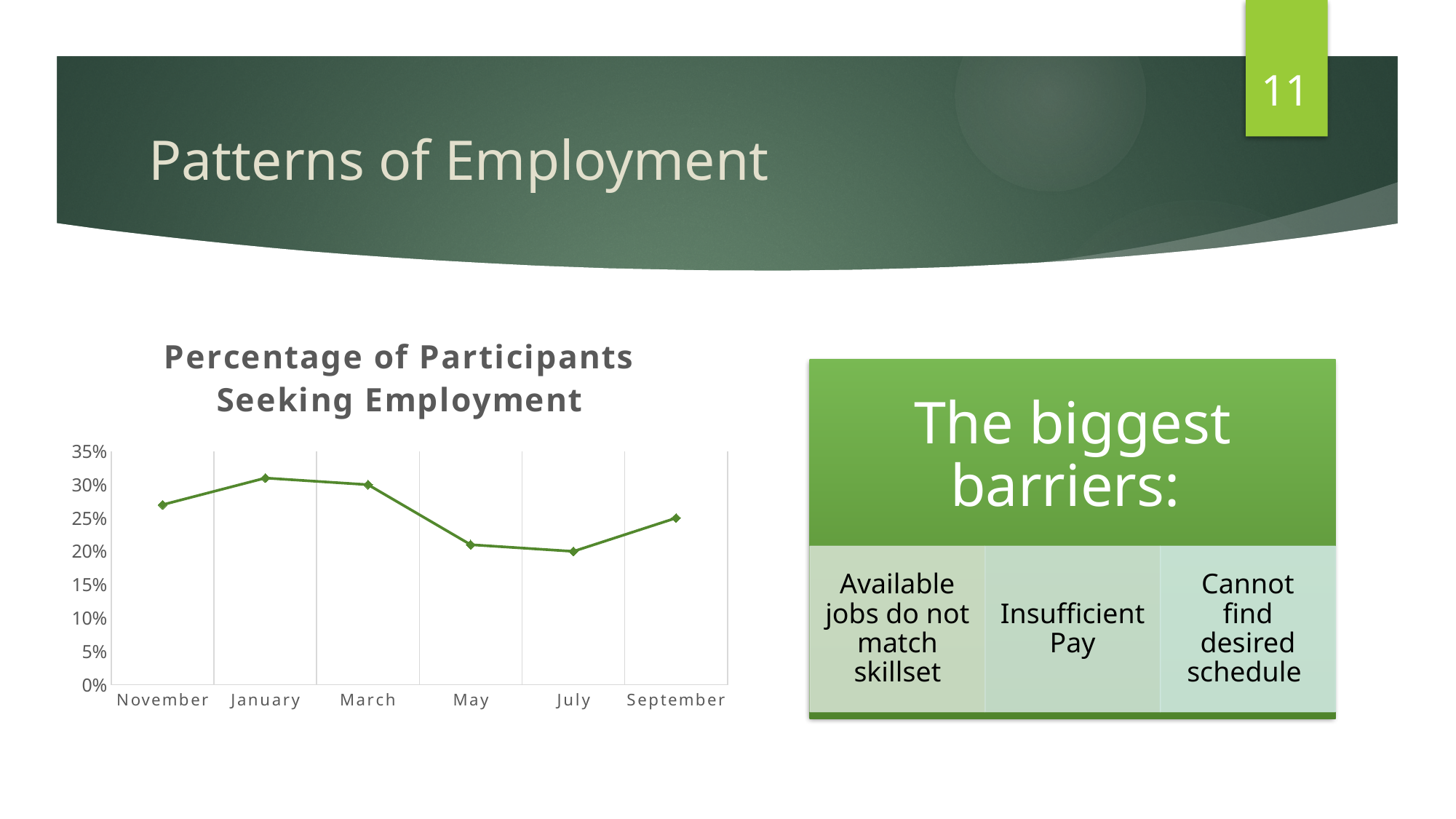
Is the value for November greater or less than 25%? greater Do the values rise or fall from January to July? fall Which is higher, the value for November or the value for July? November Is the value for July greater or less than 25%? less Which is higher, the value for January or the value for May? January Is the value for March greater or less than 25%? greater What kind of chart is shown on the slide? line chart What is the title of the chart? Percentage of Participants Seeking Employment How many months are plotted on the x axis of the chart? 6